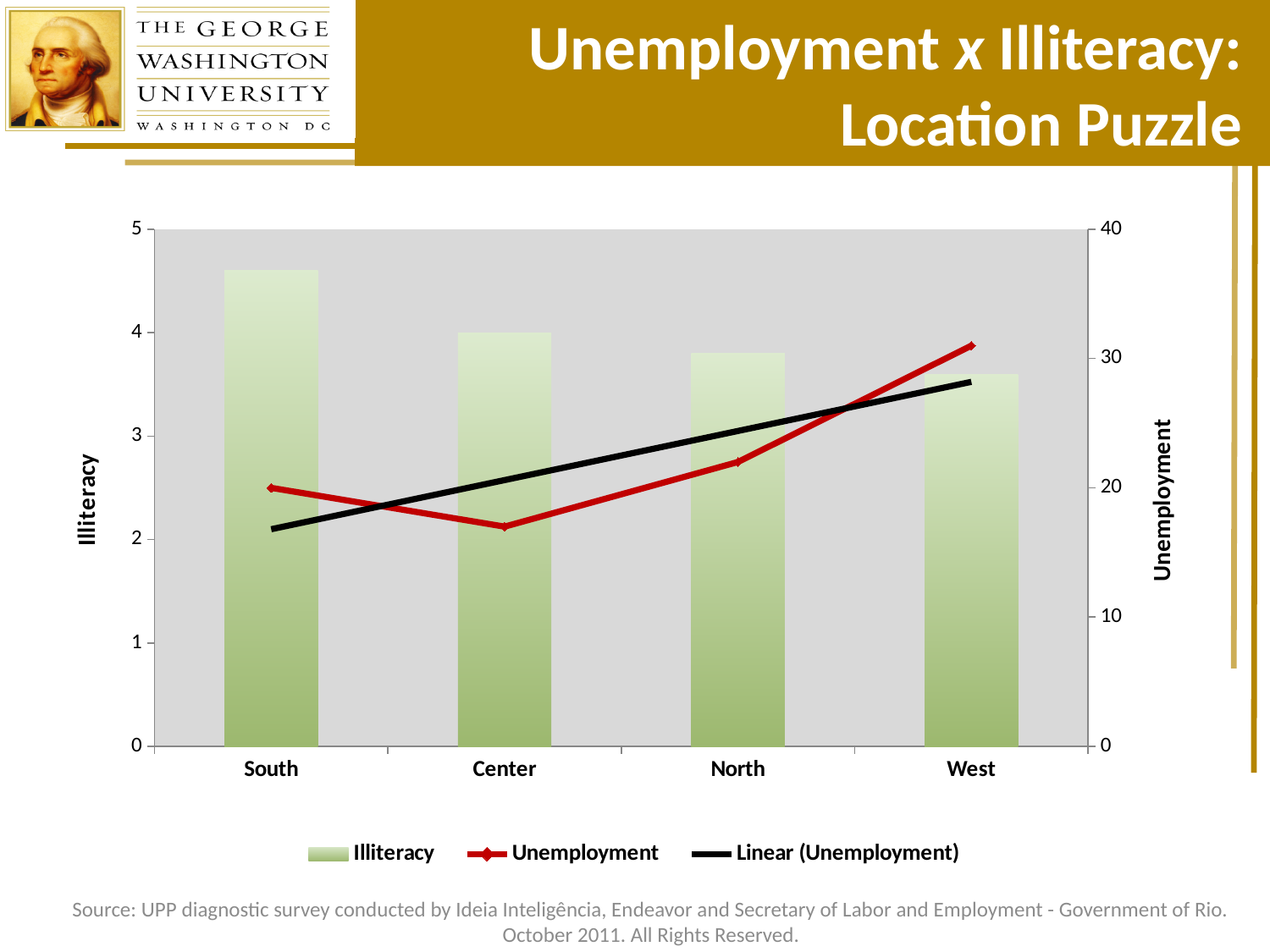
Which region has the lowest Unemployment value? Center Which region has the highest Unemployment value? West Is the Unemployment value for West greater or less than 30? greater Which region has the highest Illiteracy bar? South What kind of chart is shown on the slide? A combined bar and line chart What is the label on the right-hand vertical axis of the chart? Unemployment Is the Illiteracy value for South greater or less than 4? greater Which region has the lowest Illiteracy bar? West How many regions are shown on the x axis of the chart? 4 How many series does the chart legend list? 3 Do the Illiteracy bars rise or fall from South to West? fall Is the Unemployment value for Center greater or less than 20? less